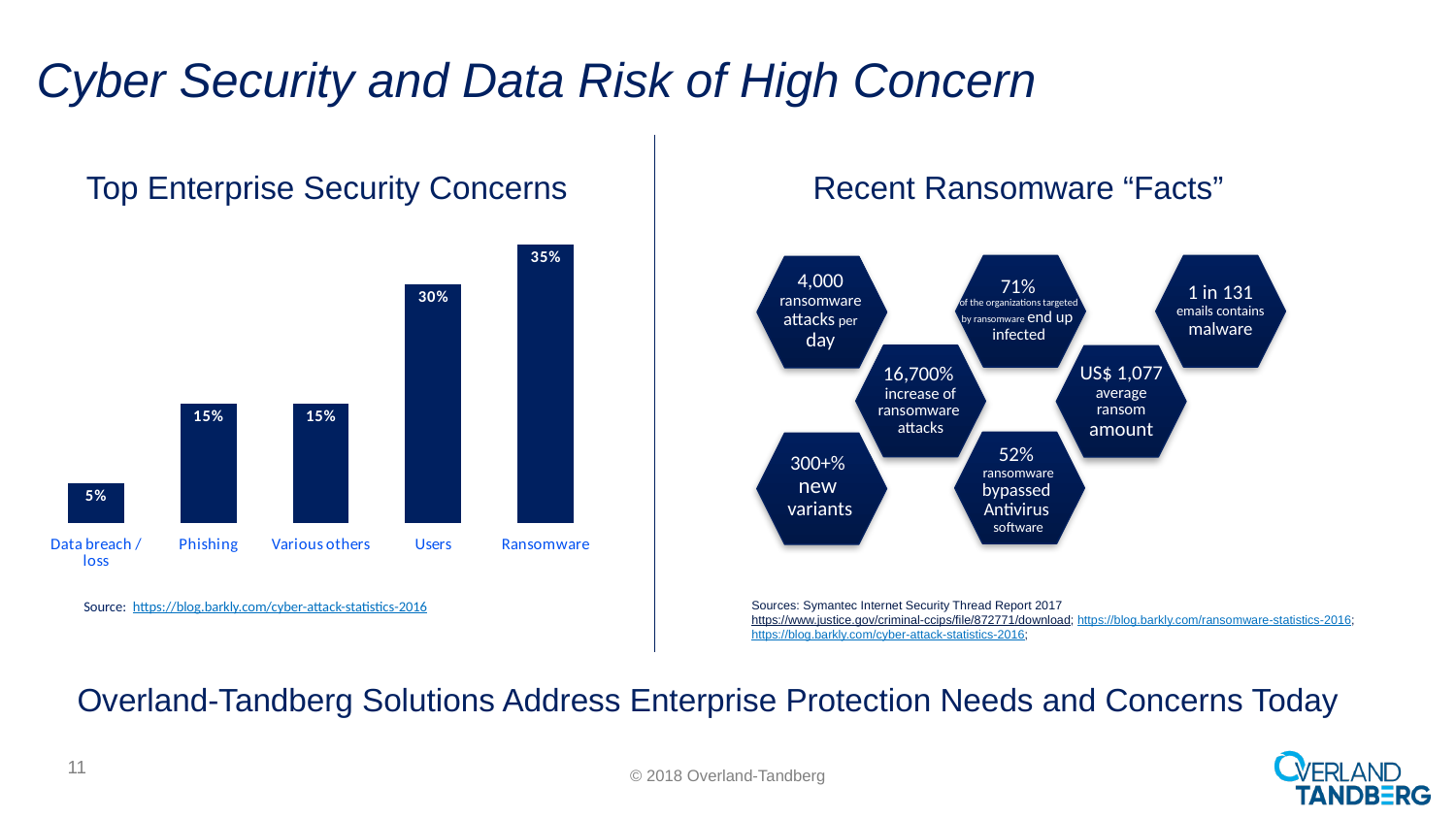
What is the value for Data breach / loss in the Top Enterprise Security Concerns chart? 5% What is the value for Phishing in the Top Enterprise Security Concerns chart? 15% Which category has the lowest value in the Top Enterprise Security Concerns chart? Data breach / loss Which category has the highest value in the Top Enterprise Security Concerns chart? Ransomware What is the value for Ransomware in the Top Enterprise Security Concerns chart? 35% In the Top Enterprise Security Concerns chart, which is larger, the value for Users or the value for Phishing? Users What is the difference between the values for Users and Data breach / loss in the Top Enterprise Security Concerns chart? 25% What is the value for Users in the Top Enterprise Security Concerns chart? 30% What is the difference between the values for Ransomware and Users in the Top Enterprise Security Concerns chart? 5% What is the title of the chart on the left side of the slide? Top Enterprise Security Concerns What kind of chart is the Top Enterprise Security Concerns chart? Bar chart How many categories are shown in the Top Enterprise Security Concerns chart? 5